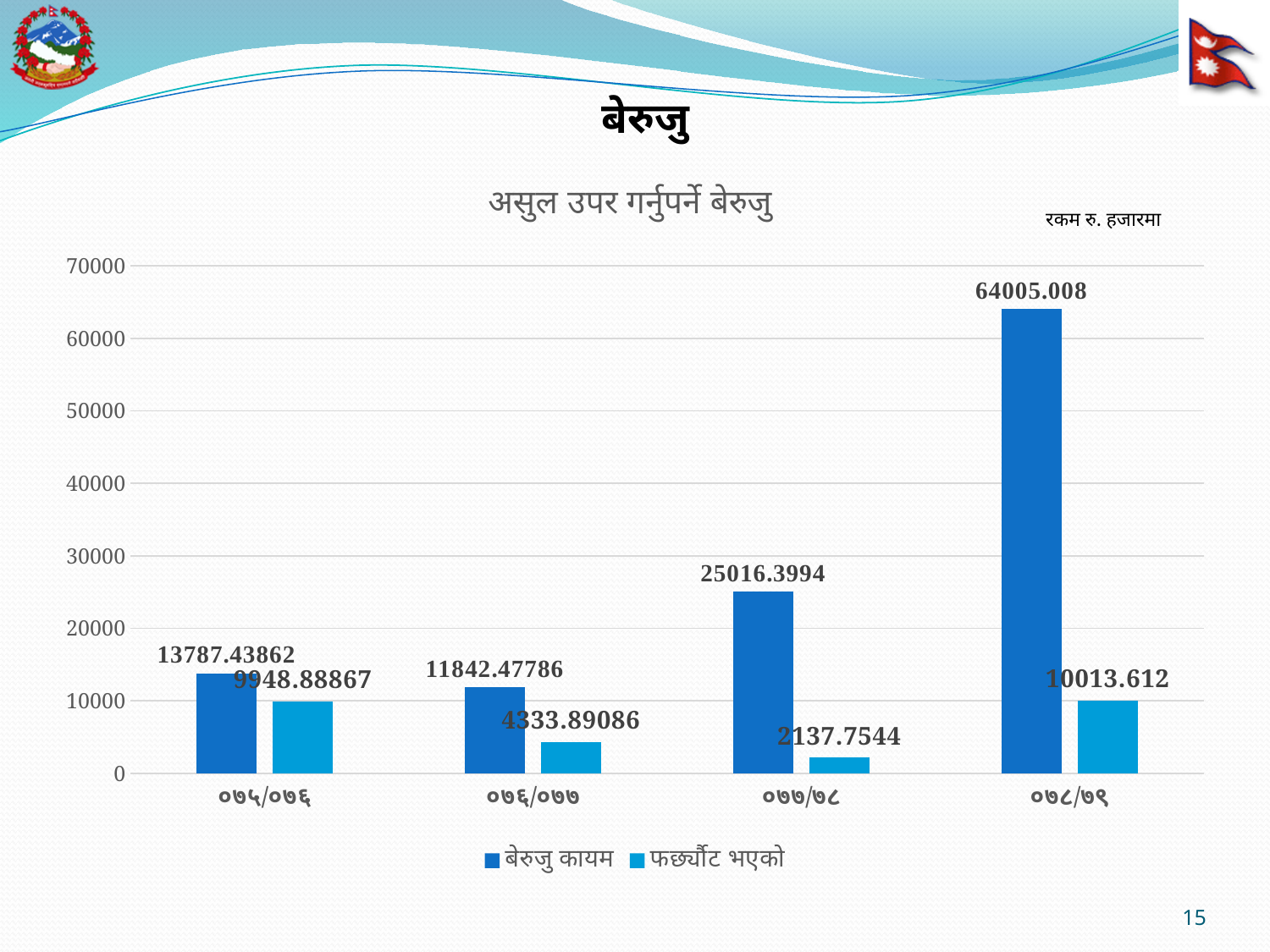
What type of chart is shown on the slide? bar chart What is the value of फर्छ्यौट भएको for ०७५/०७६? 9948.88867 What is the value of बेरुजु कायम for ०७७/७८? 25016.3994 How many series does the legend list? 2 Which category has the lowest value for फर्छ्यौट भएको? ०७७/७८ Which category has the highest value for बेरुजु कायम? ०७८/७९ What is the value of बेरुजु कायम for ०७८/७९? 64005.008 What is the difference between बेरुजु कायम and फर्छ्यौट भएको for ०७८/७९? 53991.396 Which is larger: फर्छ्यौट भएको for ०७५/०७६ or फर्छ्यौट भएको for ०७८/७९? ०७८/७९ What is the value of फर्छ्यौट भएको for ०७६/०७७? 4333.89086 What unit note is shown above the chart on the right? रकम रु. हजारमा How many categories are shown on the x axis? 4